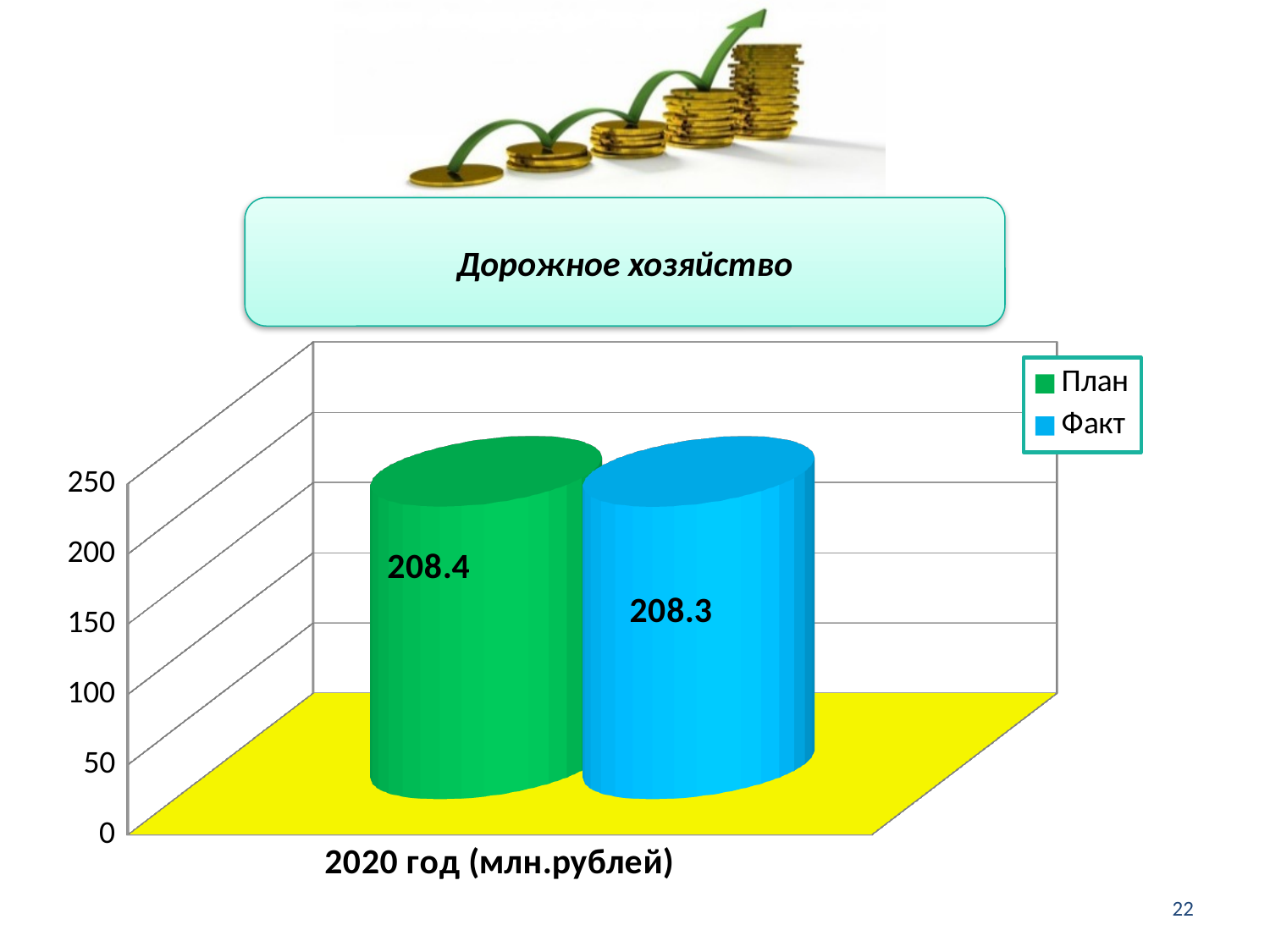
Is the value for Факт greater or less than 250? less How many series does the chart legend list? 2 Is the value for План greater or less than 200? greater Which colour represents the Факт series in the chart? blue What is the difference between the План and Факт values? 0.1 What is the category label shown on the x axis of the chart? 2020 год (млн.рублей) What kind of chart is shown on the slide? bar chart How many categories are shown on the x axis of the chart? 1 What is the value for План in the chart? 208.4 What is the value for Факт in the chart? 208.3